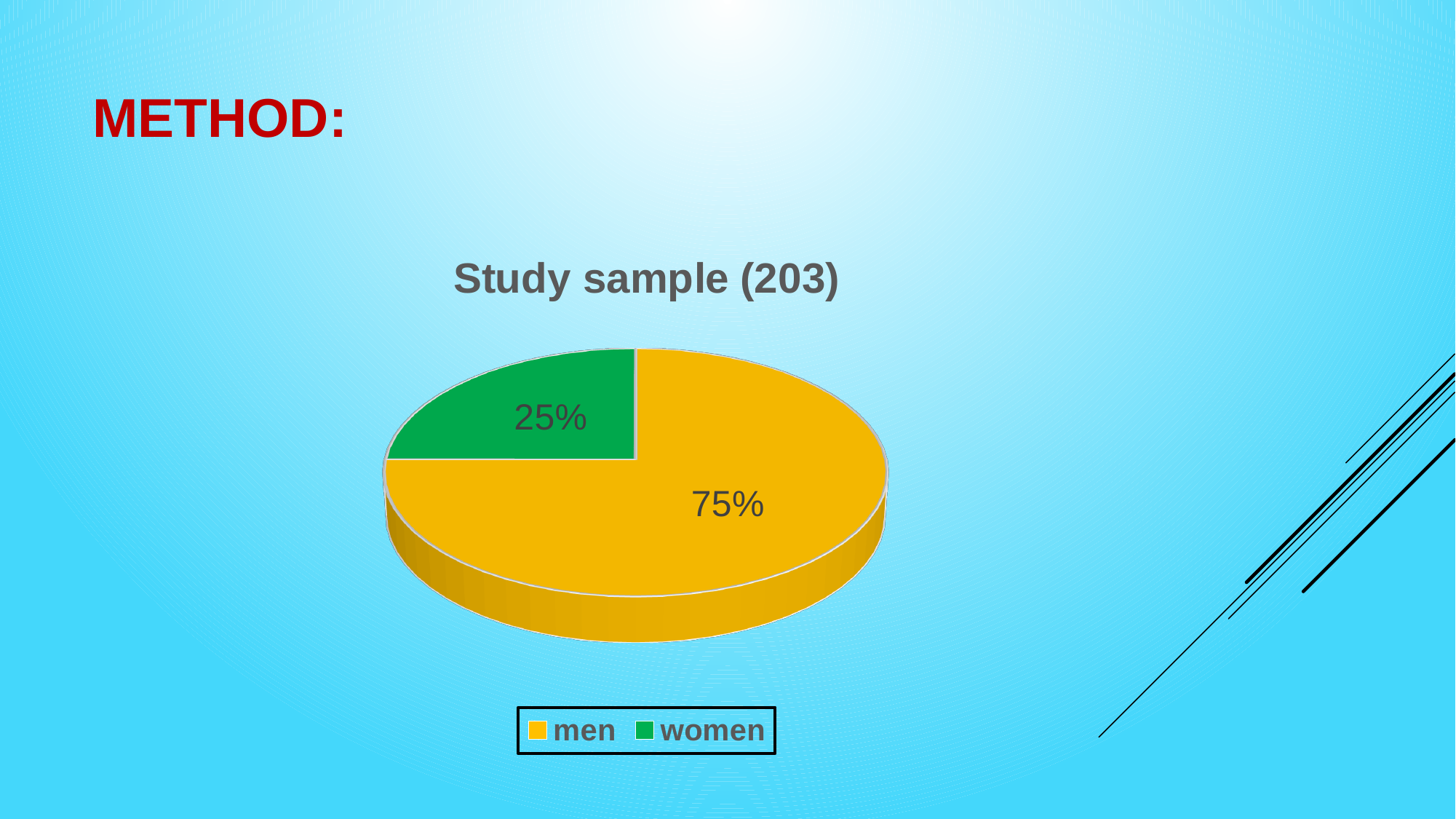
What share of the study sample is men? 75% Is the share for women greater or less than 50%? less How many categories does the pie chart have? 2 What colour represents women in the pie chart? green Which is larger, the share for men or the share for women? men What is the difference in percentage points between the men and women shares? 50 percentage points What share of the study sample is women? 25% What kind of chart is shown on the slide? pie chart How many entries does the legend list? 2 Which category has the largest share of the pie? men What is the title of the chart? Study sample (203) Which category has the smallest share of the pie? women